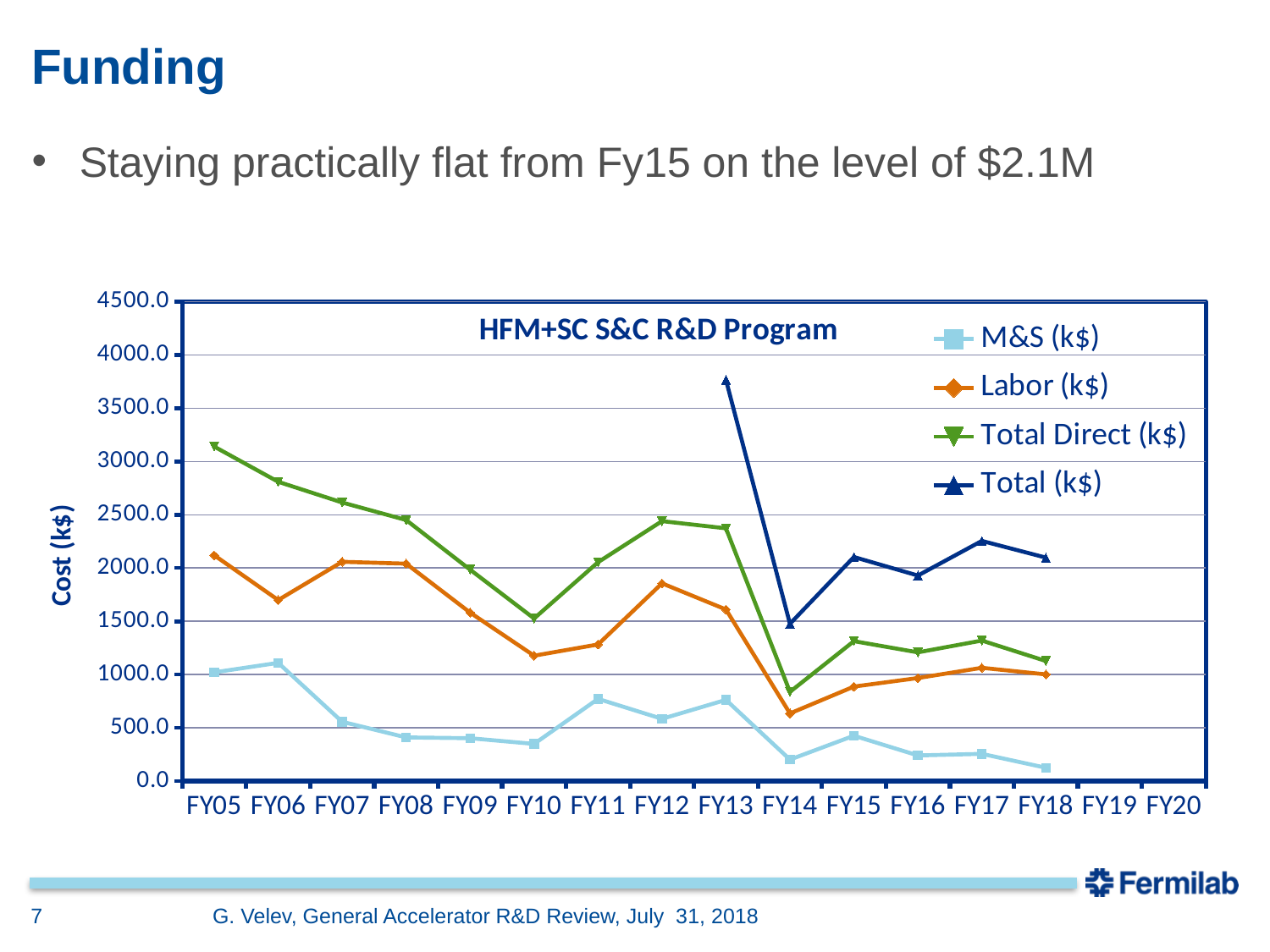
Is the Total Direct (k$) value for FY10 greater or less than 2000? less What is the label on the y axis? Cost (k$) What is the title of the chart? HFM+SC S&C R&D Program In which fiscal year is the Total Direct (k$) series at its highest? FY05 Is the Total (k$) value for FY13 greater or less than 3500? greater Which is larger, the M&S (k$) value for FY11 or for FY12? FY11 How many fiscal years are labelled on the x axis? 16 How many series does the legend list? 4 Is the M&S (k$) value for FY18 greater or less than 500? less What kind of chart is shown on the slide? line chart In which fiscal year is the Labor (k$) series at its lowest? FY14